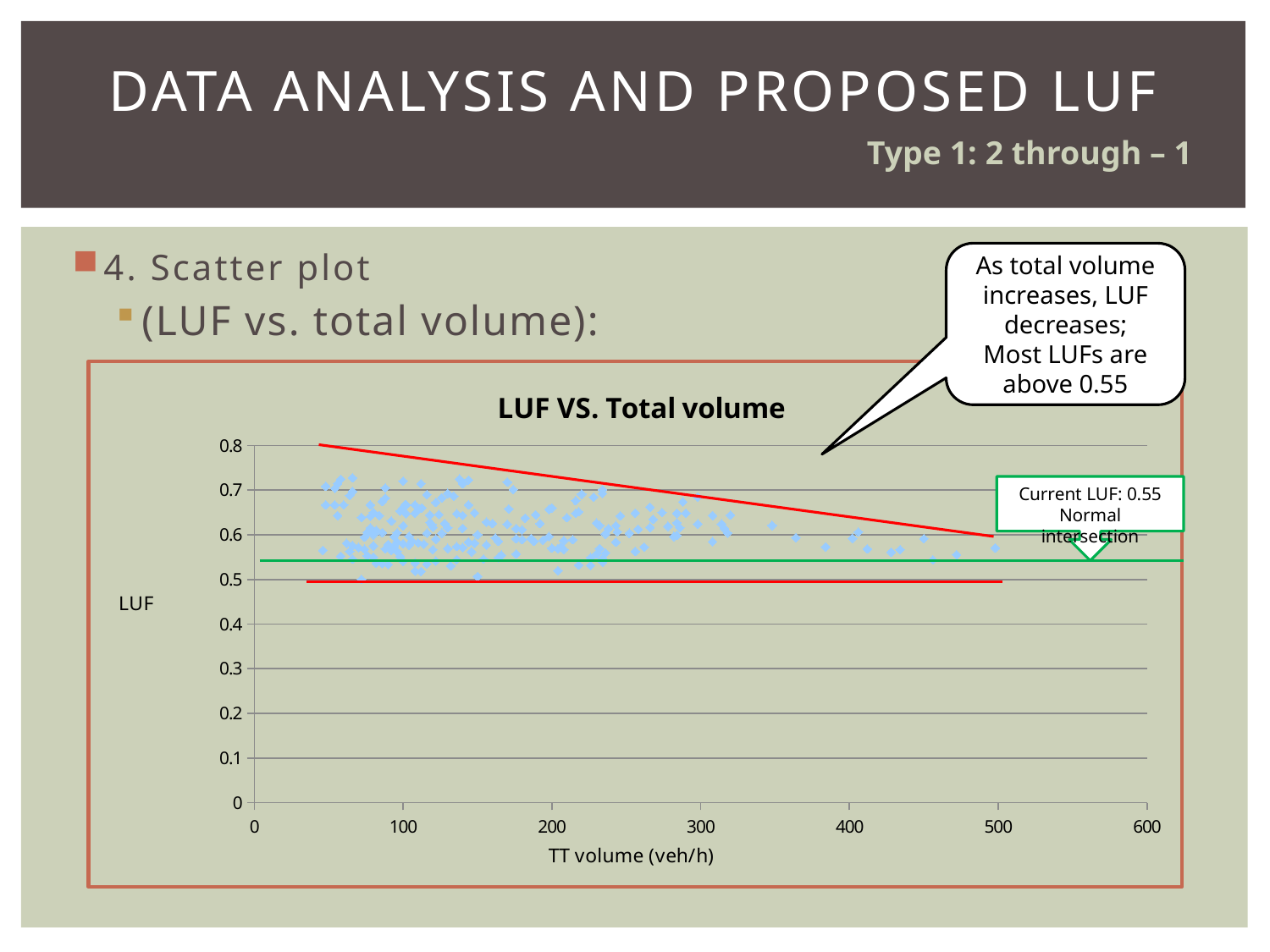
Is the lowest plotted LUF value greater or less than 0.6? less What LUF value does the green horizontal line labelled 'Current LUF' mark? 0.55 What is the title of the chart? LUF VS. Total volume According to the chart, do LUF values rise or fall as TT volume increases? Fall Is the TT volume of the rightmost plotted point greater or less than 400? greater What kind of chart is shown on the slide? Scatter plot Is the highest plotted LUF value greater or less than 0.8? less